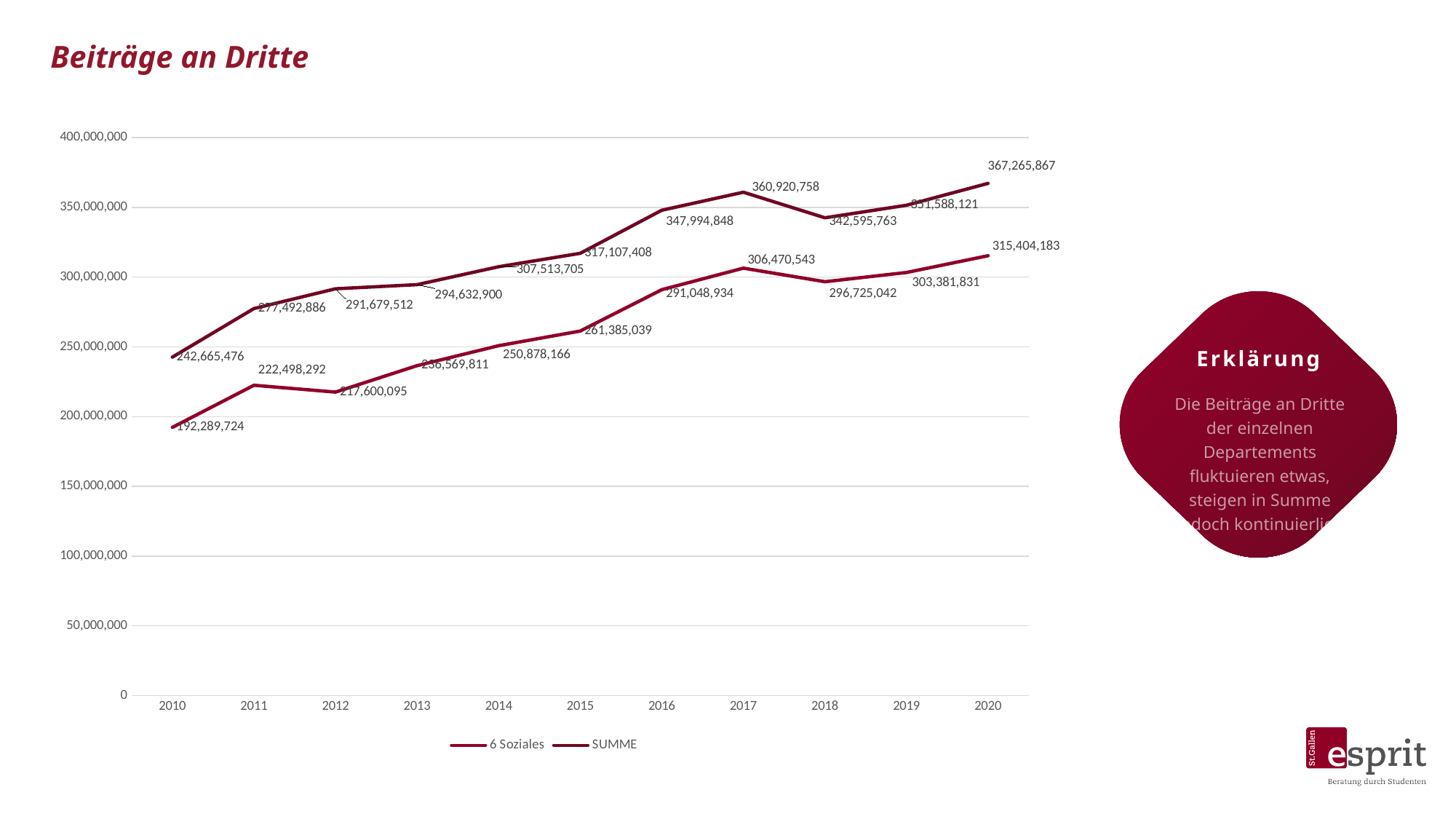
What is the value for 6 Soziales in 2018? 296,725,042 How many years are shown on the x axis? 11 What type of chart is shown on the slide? Line chart What is the value for 6 Soziales in 2010? 192,289,724 What is the SUMME value for 2020? 367,265,867 How many series does the legend list? 2 In which year is the SUMME series highest? 2020 In which year is the 6 Soziales series lowest? 2010 Is the value for 6 Soziales in 2015 greater or less than 250,000,000? greater Which is larger in 2017: the SUMME value or the 6 Soziales value? SUMME What is the SUMME value for 2017? 360,920,758 What is the difference between SUMME and 6 Soziales in 2020? 51,861,684